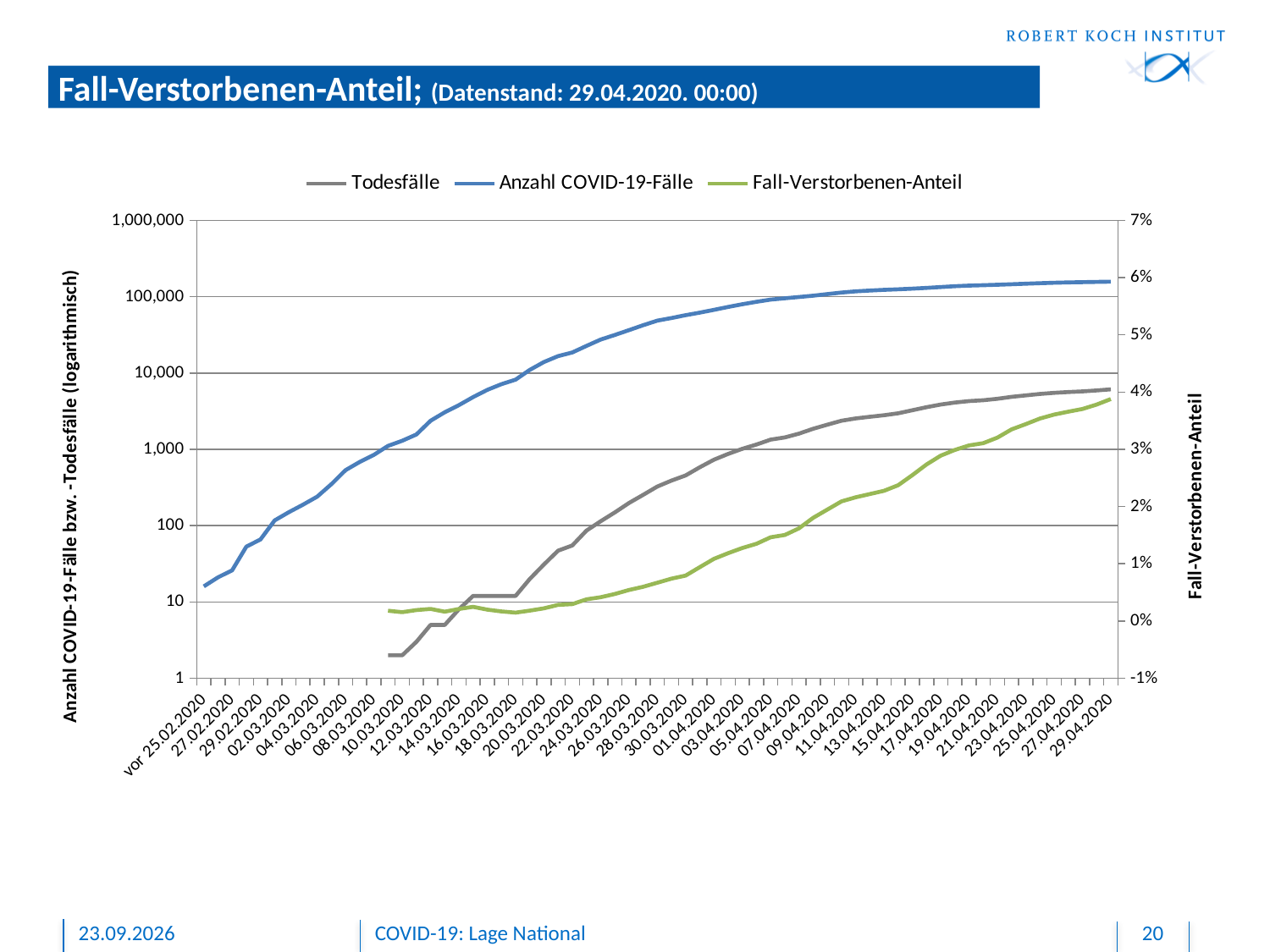
What is the label of the right-hand vertical axis? Fall-Verstorbenen-Anteil Does the Anzahl COVID-19-Fälle line rise or fall from left to right along the x axis? rise On 29.04.2020, which is larger: Anzahl COVID-19-Fälle or Todesfälle? Anzahl COVID-19-Fälle Is the value for Fall-Verstorbenen-Anteil on 24.03.2020 greater or less than 1%? less How many series does the legend list? 3 Is the value for Fall-Verstorbenen-Anteil on 29.04.2020 greater or less than 3%? greater Is the value for Anzahl COVID-19-Fälle on 02.03.2020 greater or less than 100? greater What kind of chart is shown on the slide? line chart What colour is the Fall-Verstorbenen-Anteil line? green